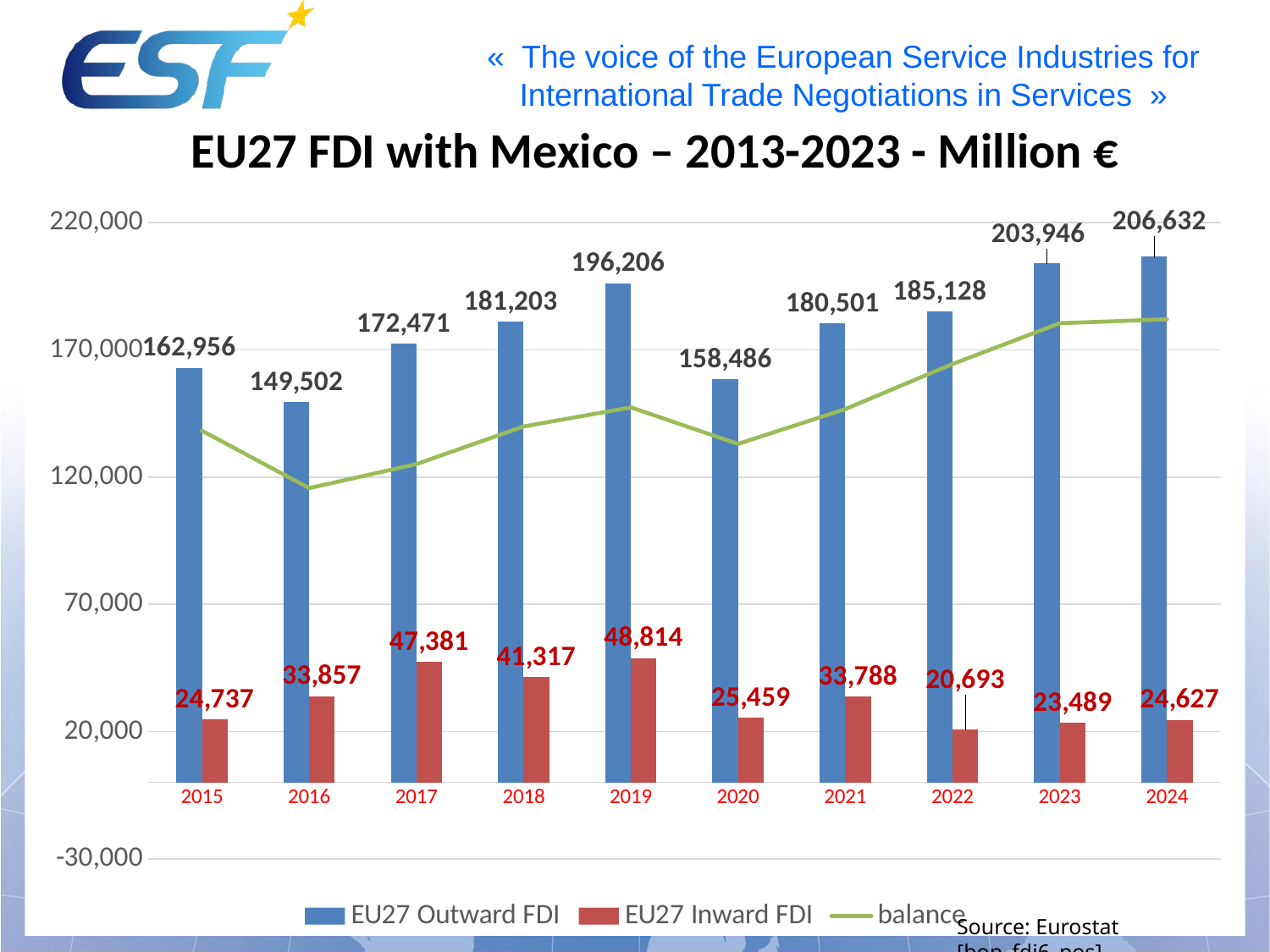
What is the EU27 Inward FDI value for 2022? 20,693 How many series does the legend list? 3 Does EU27 Outward FDI rise or fall from 2020 to 2024? rise Which year has the highest EU27 Outward FDI? 2024 How many years are shown on the x axis? 10 What kind of chart is used for the EU27 Outward FDI series? bar chart Which year has the lowest EU27 Outward FDI? 2016 Is the balance value for 2024 greater or less than 170,000? greater Is EU27 Inward FDI larger in 2017 or in 2018? 2017 What is the EU27 Outward FDI value for 2019? 196,206 What is the difference between EU27 Outward FDI and EU27 Inward FDI in 2024? 182,005 Which year has the lowest EU27 Inward FDI? 2022